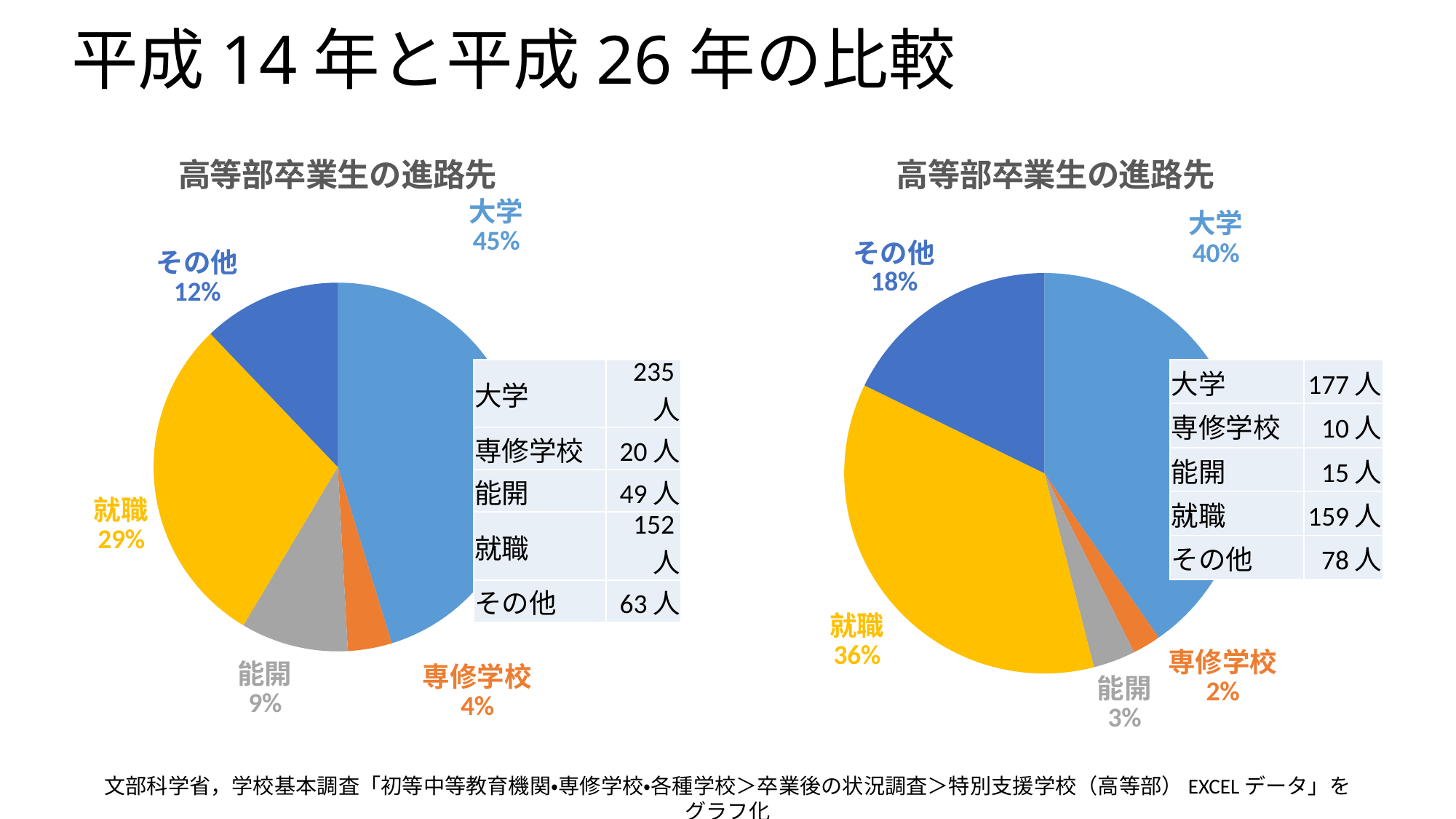
What type of chart is used on the right side of the slide? Pie chart In the left pie chart, which category has the largest slice? 大学 In the right pie chart, what share does 就職 have? 36% In the left pie chart, what share does 能開 have? 9% What is the title of the right chart? 高等部卒業生の進路先 In the left pie chart, what share does 大学 have? 45% In the right pie chart, which is larger, 大学 or 就職? 大学 In the right pie chart, which category has the smallest slice? 専修学校 In the right pie chart, how many people are listed for その他 in the table? 78人 In the left pie chart, how many people are listed for 就職 in the table? 152人 How many categories does the left pie chart show? 5 In the left pie chart, what is the difference in percentage points between 大学 and 就職? 16